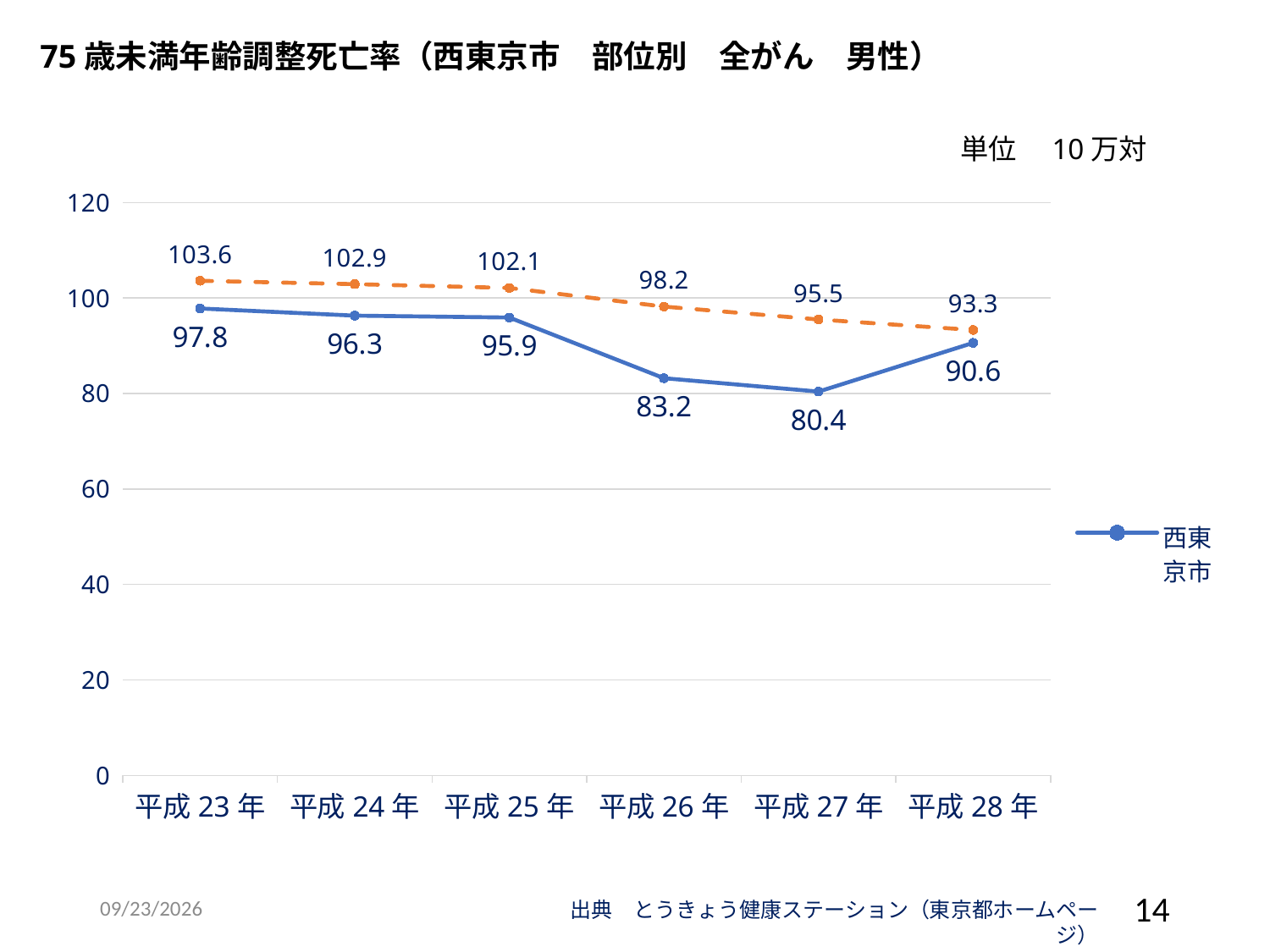
In 平成27年, what is the difference between the orange dashed line value and the 西東京市 value? 15.1 What is the difference between the 西東京市 values for 平成23年 and 平成28年? 7.2 In which year is the value for 西東京市 lowest? 平成27年 How many years are shown on the x axis? 6 Which is larger for 西東京市: the value in 平成25年 or in 平成26年? 平成25年 What is the value for 西東京市 in 平成26年? 83.2 Do the values for 西東京市 rise or fall from 平成23年 to 平成27年? fall What is the value of the orange dashed line in 平成28年? 93.3 In which year is the value for 西東京市 highest? 平成23年 What unit is stated above the chart? 10万対 What kind of chart is shown on the slide? line chart What is the value for 西東京市 in 平成23年? 97.8